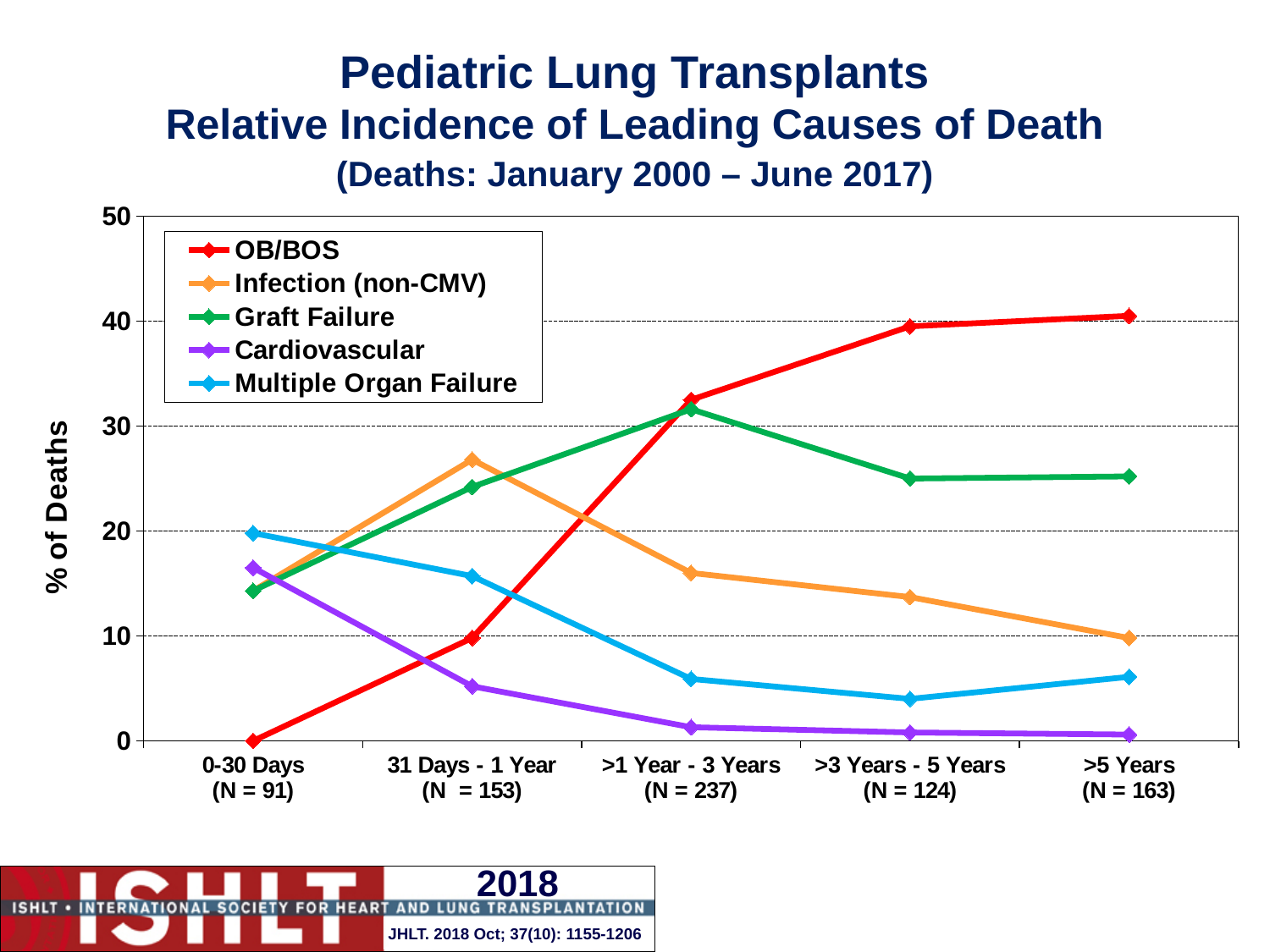
Is the value for Infection (non-CMV) at 31 Days - 1 Year greater or less than 20? greater How many series does the legend list? 5 Does the OB/BOS line rise or fall from 0-30 Days to >5 Years? Rise Which cause of death has the lowest % of deaths at >5 Years? Cardiovascular What is the N shown for the >1 Year - 3 Years category? N = 237 How many time-period categories are shown on the x axis? 5 Is the value for Graft Failure at >1 Year - 3 Years greater or less than 30? greater What is the value for OB/BOS at 0-30 Days? 0 Which cause of death has the highest % of deaths at 0-30 Days? Multiple Organ Failure What kind of chart is shown on the slide? Line chart At >1 Year - 3 Years, which is larger: Infection (non-CMV) or Multiple Organ Failure? Infection (non-CMV) Which cause of death has the highest % of deaths at >5 Years? OB/BOS